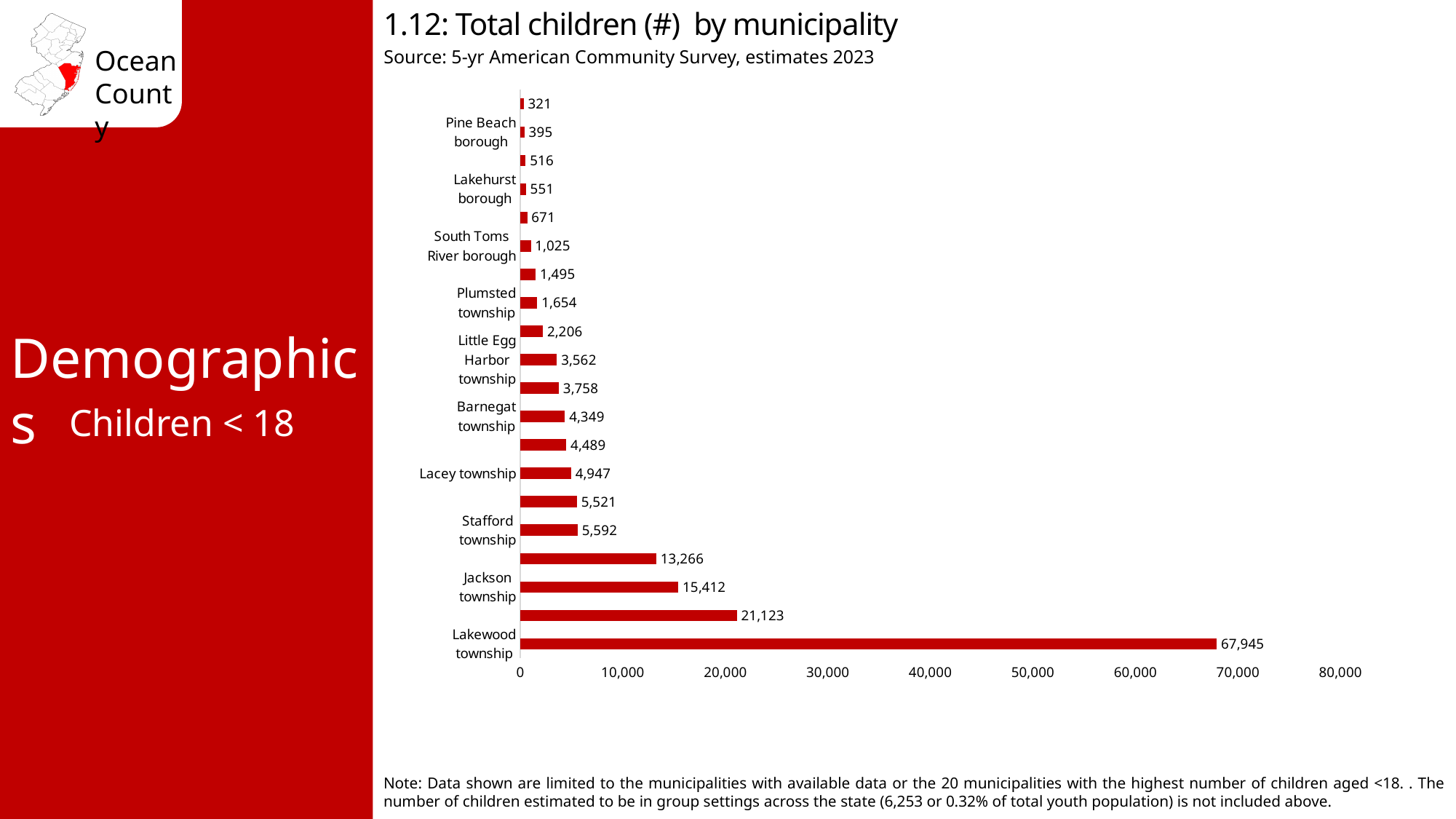
Which municipality has the highest number of children? Lakewood township What is the difference between the values for Lakewood township and Jackson township? 52,533 What is the value for Lacey township? 4,947 What is the title of the chart? 1.12: Total children (#) by municipality What type of chart is shown? bar chart Which has more children, Barnegat township or Lacey township? Lacey township How many children are shown for Jackson township? 15,412 How many bars are plotted on the chart? 20 What is the value for Stafford township? 5,592 What is the total number of children in Lakewood township? 67,945 Is the value for Jackson township greater or less than 10,000? greater What is the smallest value labelled on the chart? 321